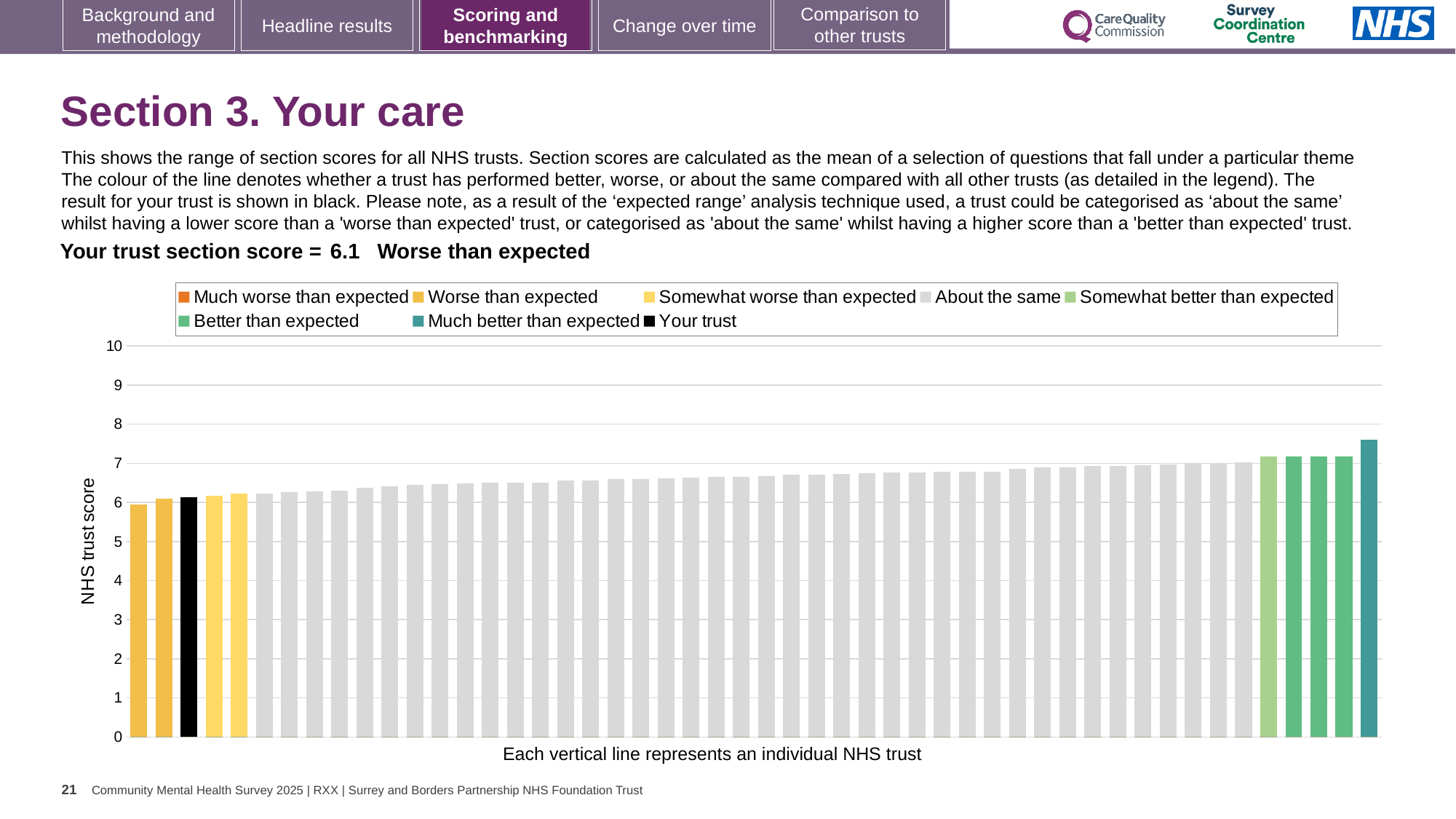
What is the section score for your trust? 6.1 Which legend category does your trust fall into according to the text above the chart? Worse than expected Do the bar values rise or fall from left to right along the x axis? rise Is the value for the shortest bar greater or less than 5? greater Which legend category does the highest bar belong to? Much better than expected What is the label on the vertical axis? NHS trust score How many bars are coloured as 'Somewhat better than expected'? 1 Is the value for the tallest bar greater or less than 7? greater Is the value for your trust greater or less than 7? less What kind of chart is shown on the slide? bar chart What colour is the bar for your trust? black How many entries does the chart legend list? 8